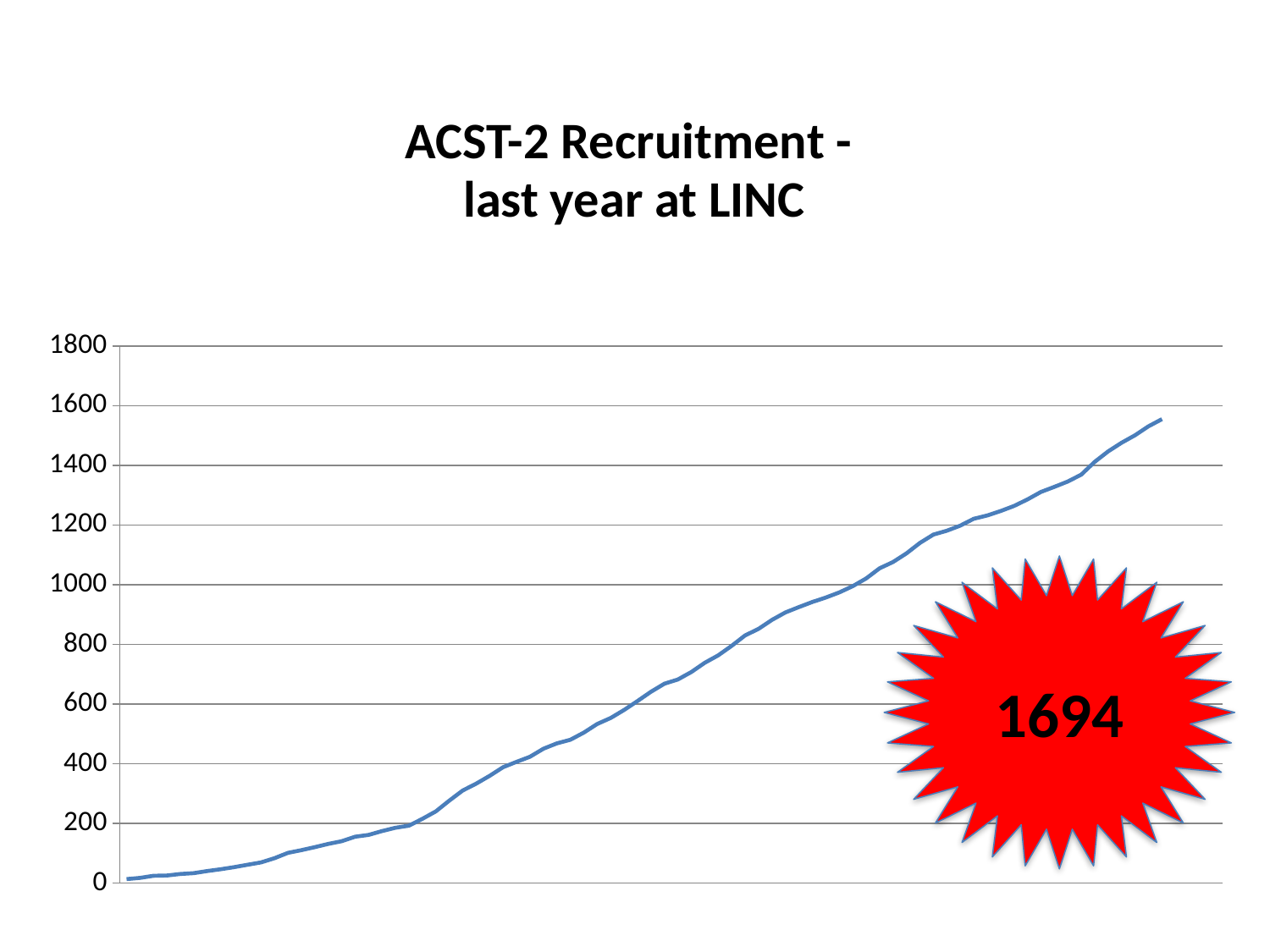
Is the value at the midpoint of the x axis greater or less than 400? greater Is the value at the right-hand end of the line greater or less than 1600? less What is the highest value shown on the y axis? 1800 Do the values of the line rise or fall from left to right along the x axis? rise How many lines are plotted on the chart? 1 What is the title of the chart on the slide? ACST-2 Recruitment - last year at LINC What kind of chart is shown on the slide? line chart Is the value at the right-hand end of the line greater or less than 1400? greater Is the value at the right-hand end of the line larger or smaller than the value at the left-hand start? larger What number is printed in the red starburst shape on the slide? 1694